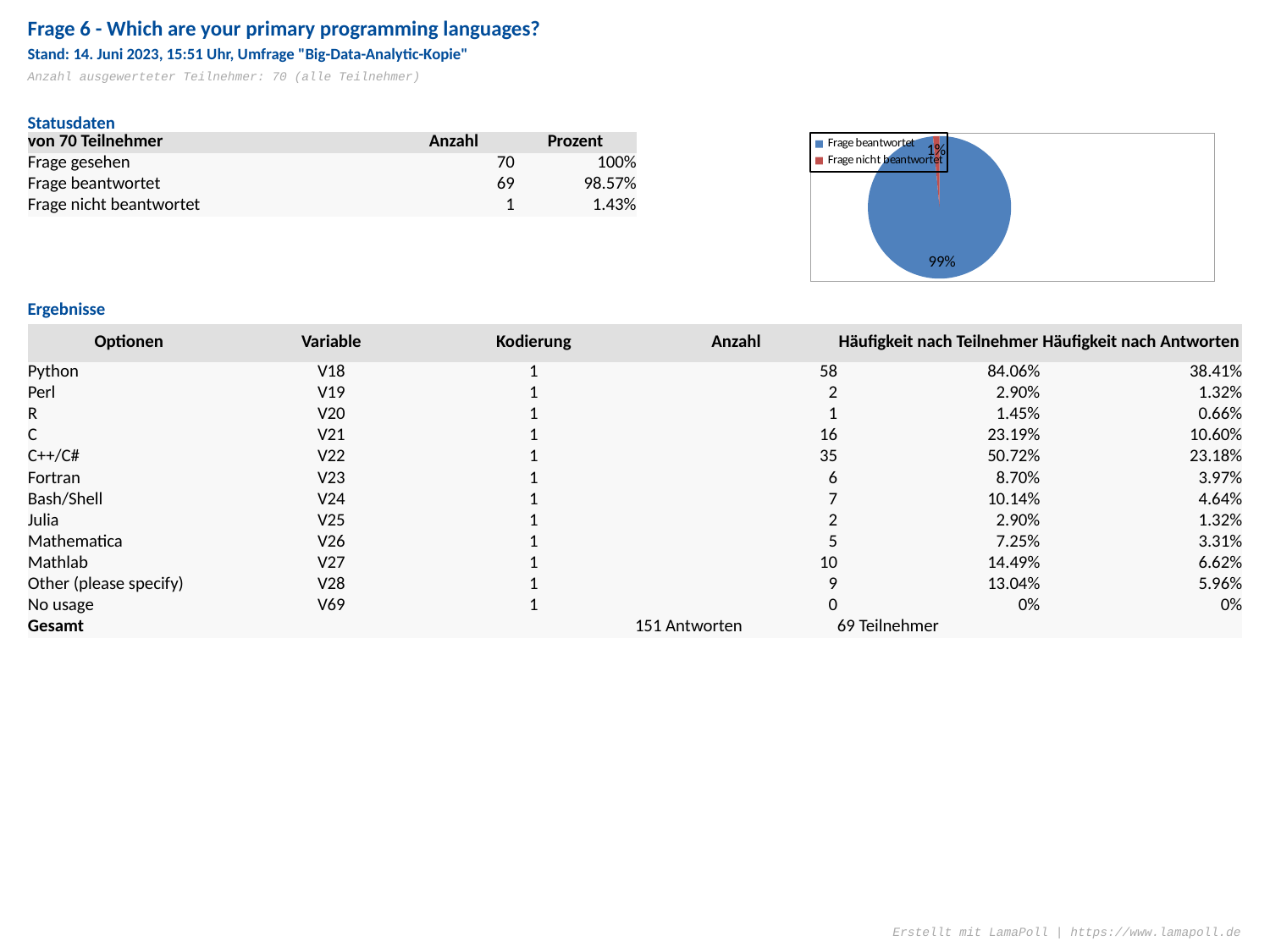
What share of the pie chart is labelled for "Frage nicht beantwortet"? 1% What is the difference in percentage points between the "Frage beantwortet" and "Frage nicht beantwortet" slices of the pie chart? 98% In the pie chart, which is larger: "Frage beantwortet" or "Frage nicht beantwortet"? Frage beantwortet What kind of chart is shown on the slide? pie chart How many entries does the legend of the pie chart list? 2 Which slice of the pie chart is the largest? Frage beantwortet What is the first entry listed in the pie chart's legend? Frage beantwortet Which slice of the pie chart is the smallest? Frage nicht beantwortet What colour is the "Frage beantwortet" slice in the pie chart? blue What share of the pie chart is labelled for "Frage beantwortet"? 99% How many slices does the pie chart have? 2